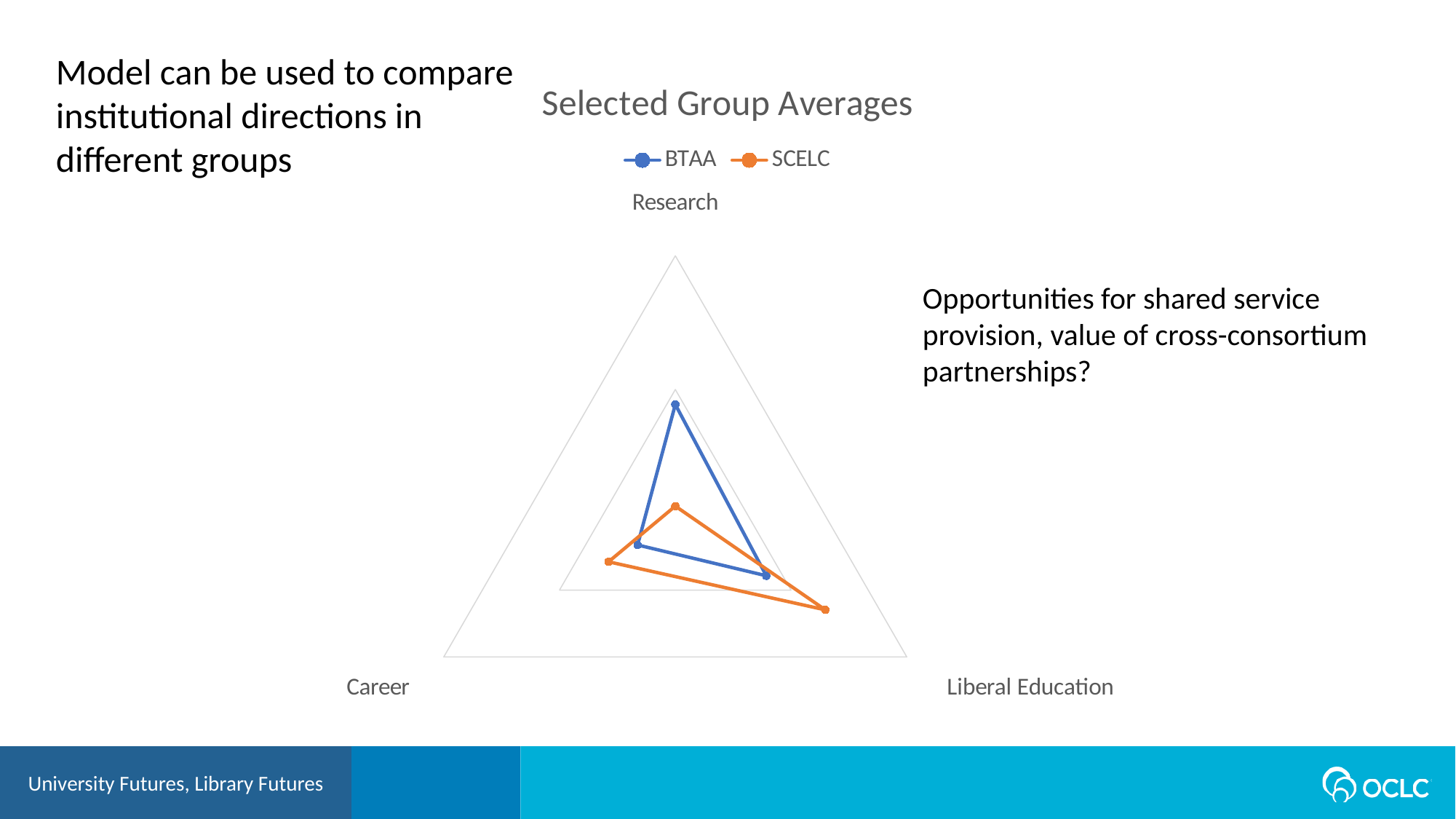
What is the title of the chart? Selected Group Averages Which group has the higher value on the Liberal Education axis, BTAA or SCELC? SCELC On which axis does BTAA have its lowest value? Career What kind of chart is shown on the slide? Radar chart Which series are listed in the chart's legend? BTAA and SCELC Which group has the higher value on the Career axis, BTAA or SCELC? SCELC Which group has the higher value on the Research axis, BTAA or SCELC? BTAA How many axes (categories) does the radar chart have? 3 How many series does the chart's legend list? 2 On which axis does SCELC have its lowest value? Research On which axis does SCELC have its highest value? Liberal Education